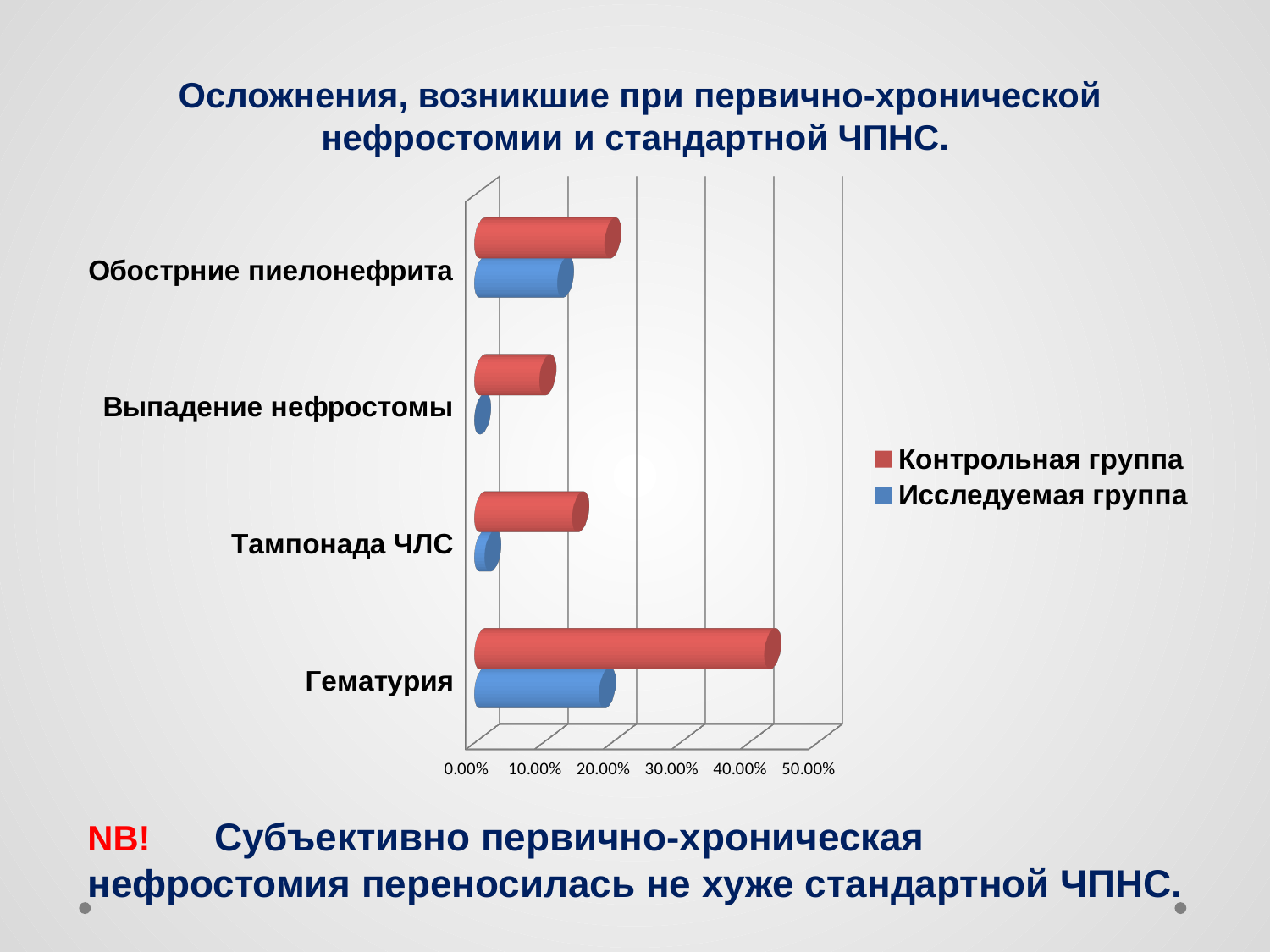
What kind of chart is shown on the slide? Bar chart Which category has the highest value for Контрольная группа? Гематурия Which category has the highest value for Исследуемая группа? Гематурия Is the value for Гематурия in Исследуемая группа greater or less than 30.00%? less For Гематурия, which group has the larger value: Контрольная группа or Исследуемая группа? Контрольная группа Which category has the lowest value for Контрольная группа? Выпадение нефростомы Is the value for Гематурия in Контрольная группа greater or less than 40.00%? greater Is the value for Тампонада ЧЛС in Контрольная группа greater or less than 20.00%? less How many complication categories are shown on the chart? 4 Which colour represents Исследуемая группа in the legend? Blue How many series does the legend list? 2